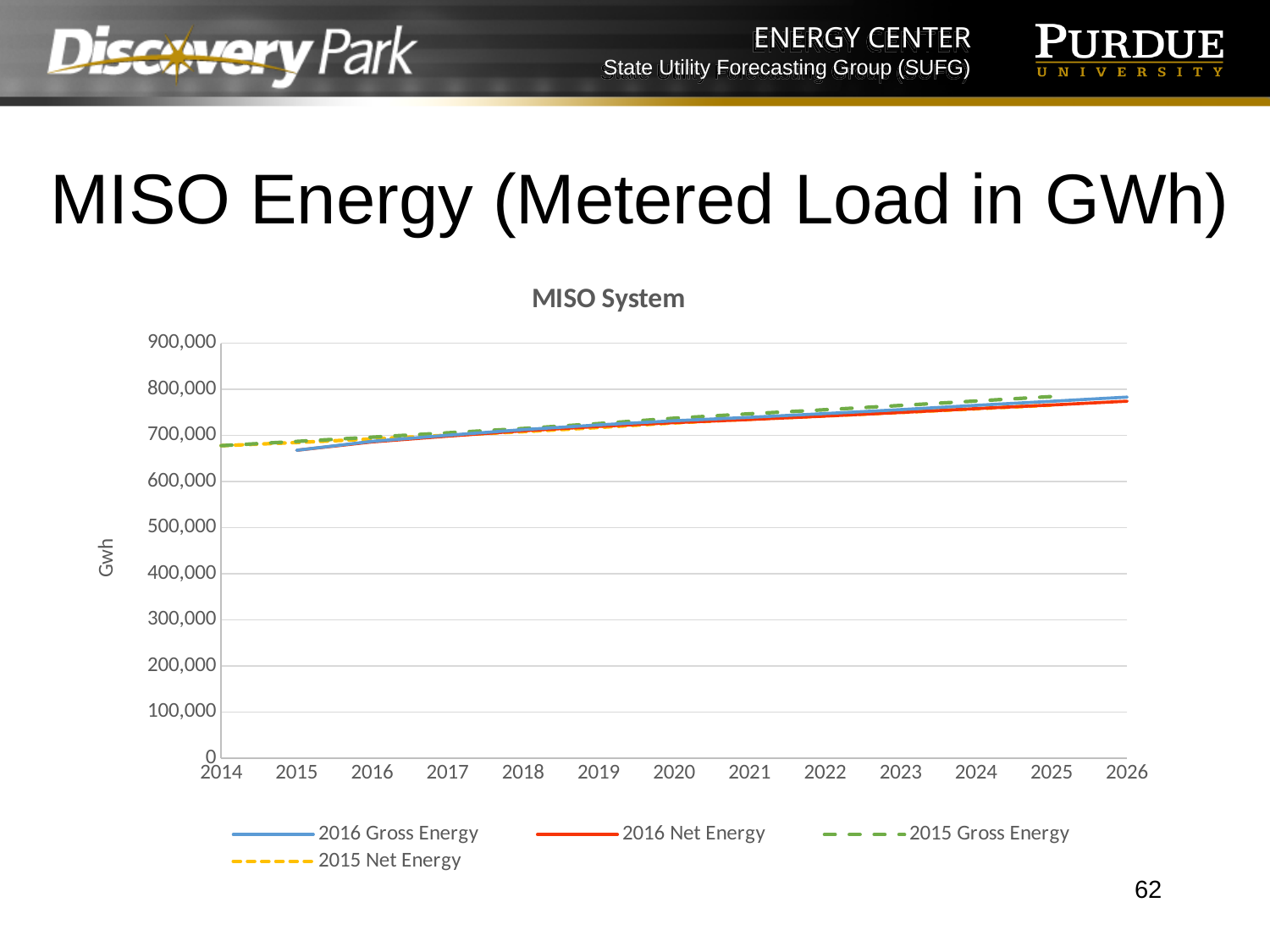
What is the title of the chart? MISO System What kind of chart is shown on the slide? line chart Is the value for 2016 Gross Energy in 2026 greater or less than 700,000? greater What is the label on the vertical axis of the chart? Gwh Is the value for 2015 Gross Energy in 2014 greater or less than 700,000? less How many year labels are shown along the x axis? 13 Do the values for 2015 Gross Energy rise or fall from 2014 to 2025? rise Is the value for 2016 Gross Energy in 2015 greater or less than 700,000? less How many series does the legend list? 4 Do the values for 2016 Gross Energy rise or fall from 2015 to 2026? rise